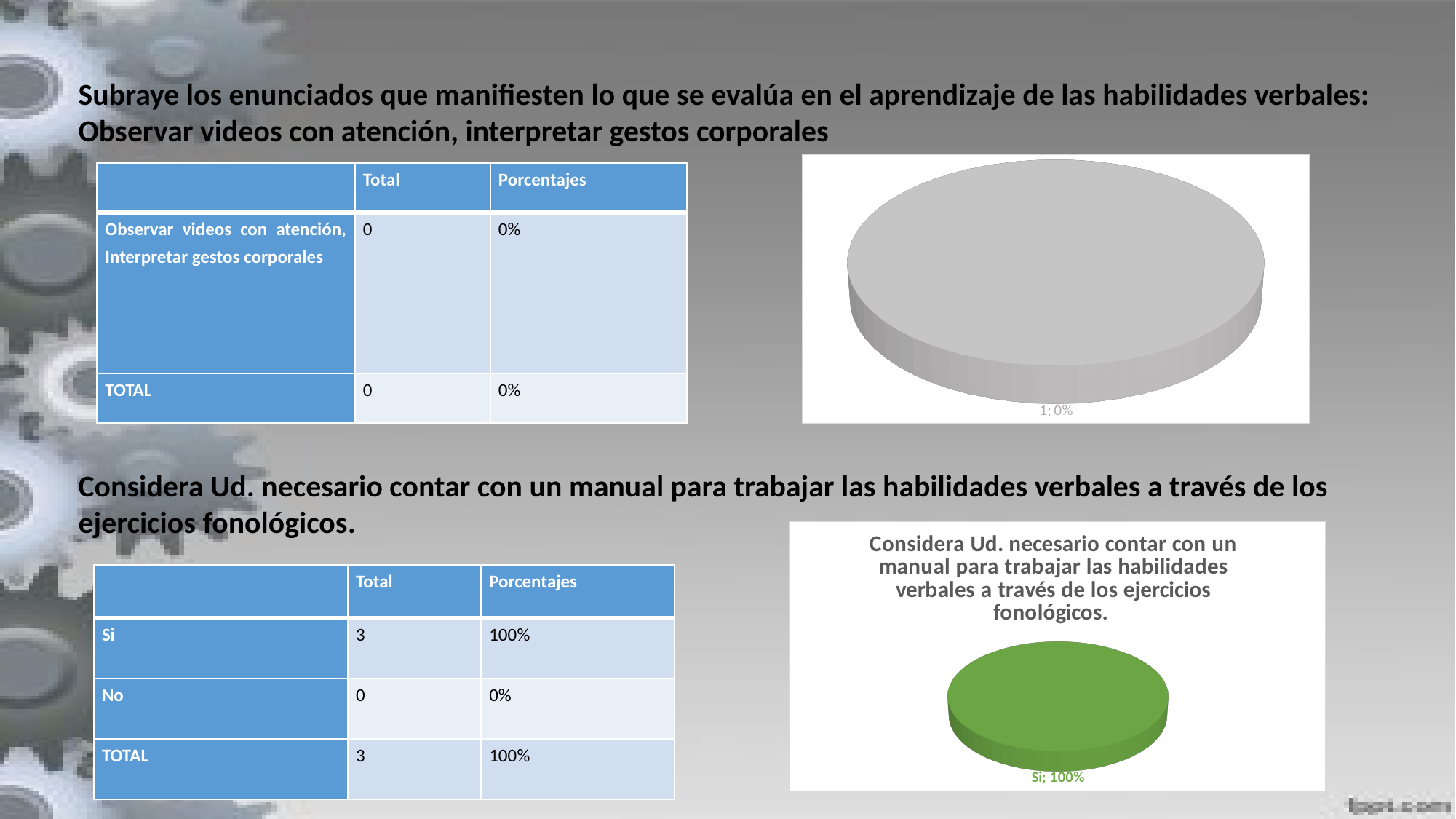
What kind of chart is the chart at the bottom right of the slide? pie chart In the top-right pie chart, what percentage is shown on the data label? 0% In the bottom-right pie chart, what share of the pie does the 'Si' slice take? 100% What kind of chart is the chart at the top right of the slide? pie chart In the bottom-right pie chart, what percentage is shown on the data label for the 'Si' slice? 100% In the bottom-right pie chart, which category is labelled on the pie? Si What is the title of the bottom-right pie chart? Considera Ud. necesario contar con un manual para trabajar las habilidades verbales a través de los ejercicios fonológicos. How many slices with data labels are shown in the bottom-right pie chart? 1 What colour is the slice in the bottom-right pie chart? green How many slices with data labels are shown in the top-right pie chart? 1